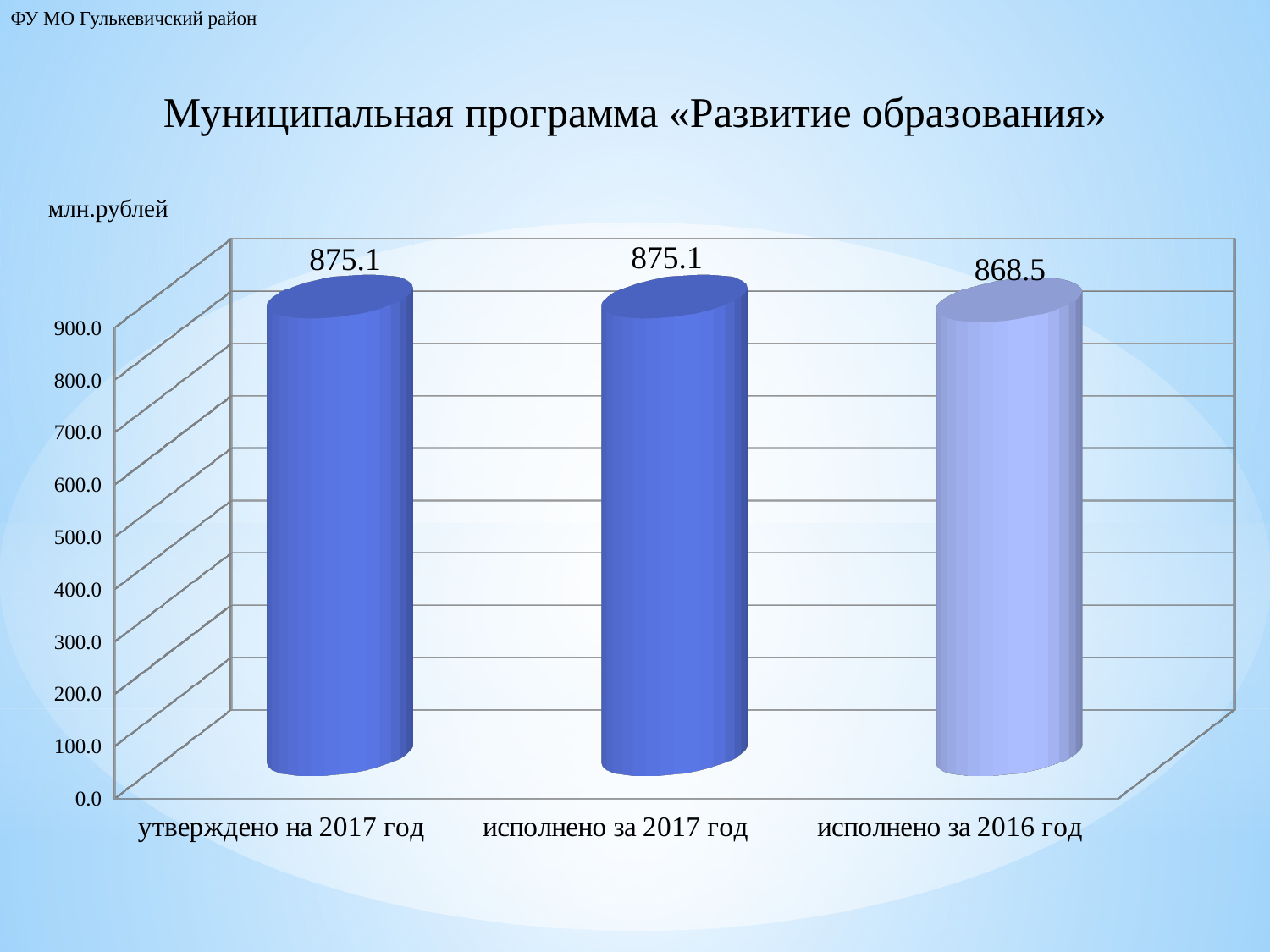
What is the value for «утверждено на 2017 год»? 875.1 Which is larger: the value for «утверждено на 2017 год» or the value for «исполнено за 2016 год»? утверждено на 2017 год What is the difference between the value for «исполнено за 2017 год» and the value for «исполнено за 2016 год»? 6.6 What is the value for «исполнено за 2016 год»? 868.5 What kind of chart is shown on the slide? bar chart Is the value for «исполнено за 2016 год» greater or less than 800.0? greater Which category has the lowest value? исполнено за 2016 год What unit is indicated for the values on the chart? млн.рублей How many categories are shown on the chart? 3 Is the value for «утверждено на 2017 год» greater or less than 900.0? less What is the difference between the value for «утверждено на 2017 год» and the value for «исполнено за 2017 год»? 0.0 What is the value for «исполнено за 2017 год»? 875.1